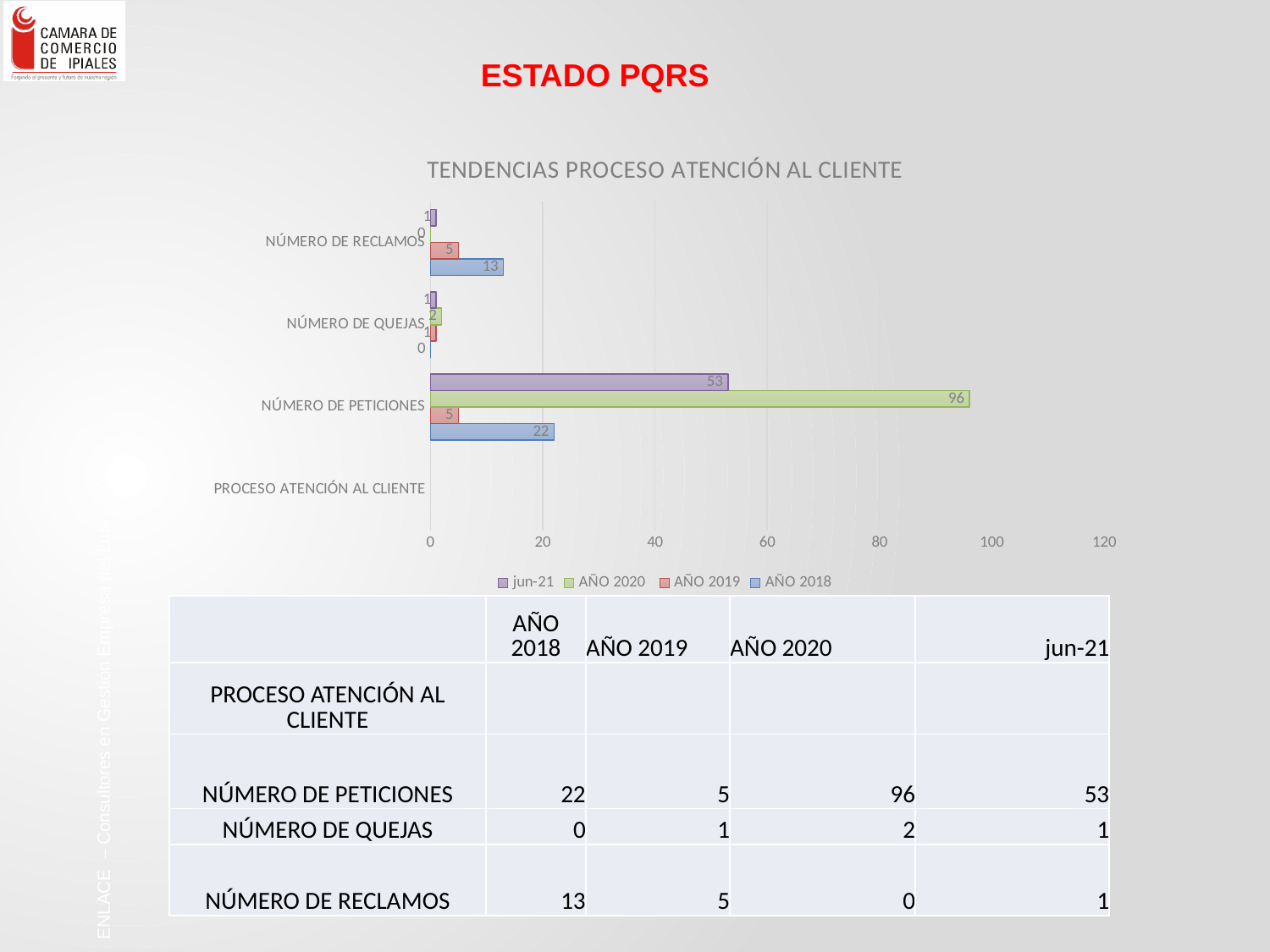
Which series has the lowest value for NÚMERO DE RECLAMOS? AÑO 2020 Which series has the highest value for NÚMERO DE PETICIONES? AÑO 2020 What is the difference between the AÑO 2020 and jun-21 values for NÚMERO DE PETICIONES? 43 What is the value for NÚMERO DE PETICIONES in the AÑO 2020 series? 96 How many series does the chart legend list? 4 Is the AÑO 2020 value for NÚMERO DE PETICIONES greater or less than 80? greater What is the title of the chart? TENDENCIAS PROCESO ATENCIÓN AL CLIENTE What is the value for NÚMERO DE RECLAMOS in the AÑO 2018 series? 13 What is the value for NÚMERO DE QUEJAS in the AÑO 2020 series? 2 What type of chart is shown on the slide? bar chart Which is larger for NÚMERO DE PETICIONES: the AÑO 2018 value or the AÑO 2019 value? AÑO 2018 What is the value for NÚMERO DE PETICIONES in the jun-21 series? 53